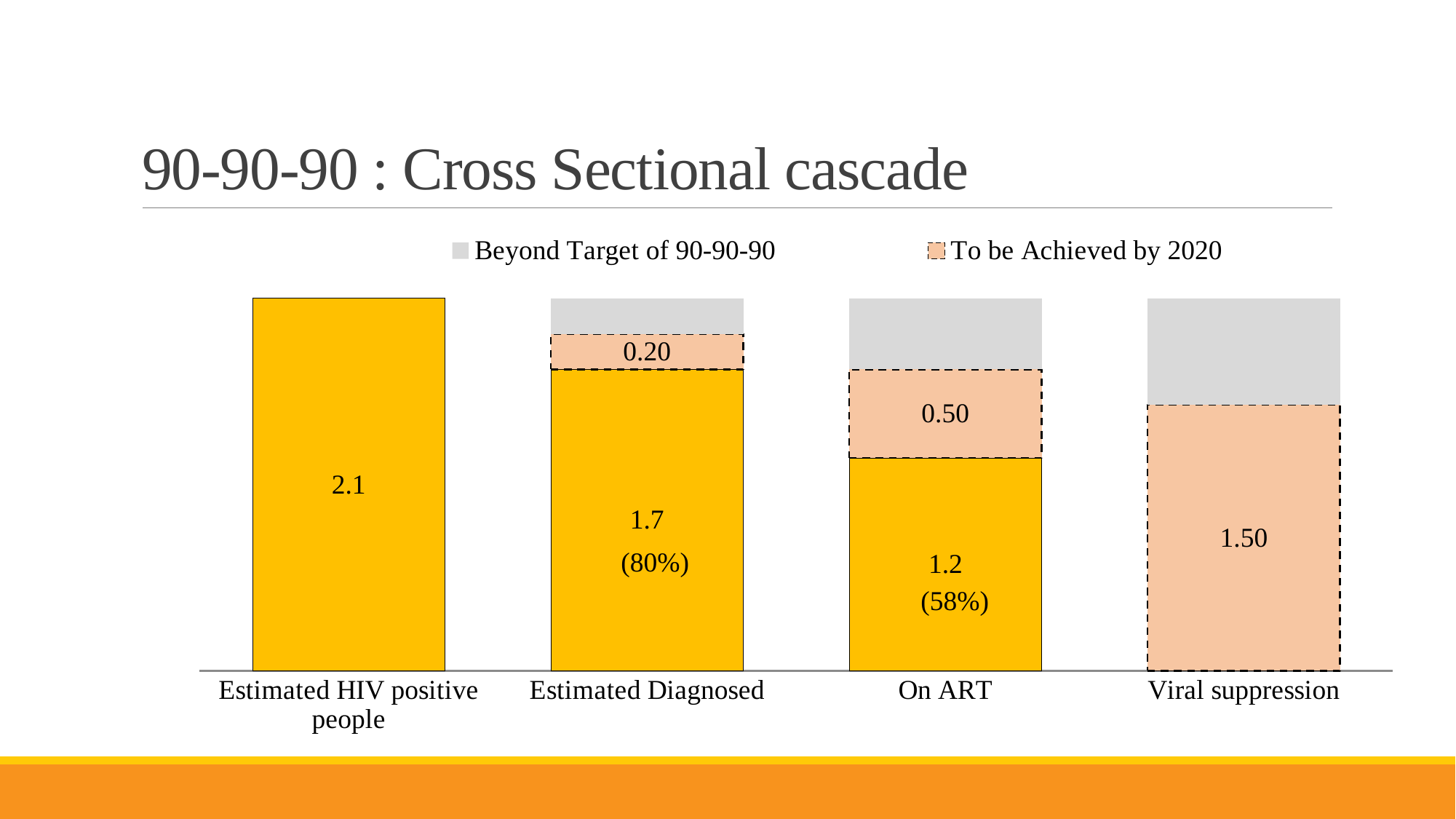
Do the yellow segment values rise or fall from Estimated HIV positive people to On ART? fall How many series does the legend list? 2 Which category has the largest 'To be Achieved by 2020' segment? Viral suppression Which is larger, the 'To be Achieved by 2020' value for On ART or for Estimated Diagnosed? On ART What percentage is shown in the On ART bar? 58% How many categories are shown on the x axis? 4 What is the 'To be Achieved by 2020' value for Viral suppression? 1.50 What is the 'To be Achieved by 2020' value for On ART? 0.50 What is the difference between the yellow values for Estimated HIV positive people and Estimated Diagnosed? 0.4 What value is shown for Estimated HIV positive people? 2.1 What value is printed in the yellow segment of the Estimated Diagnosed bar? 1.7 What is the 'To be Achieved by 2020' value for Estimated Diagnosed? 0.20